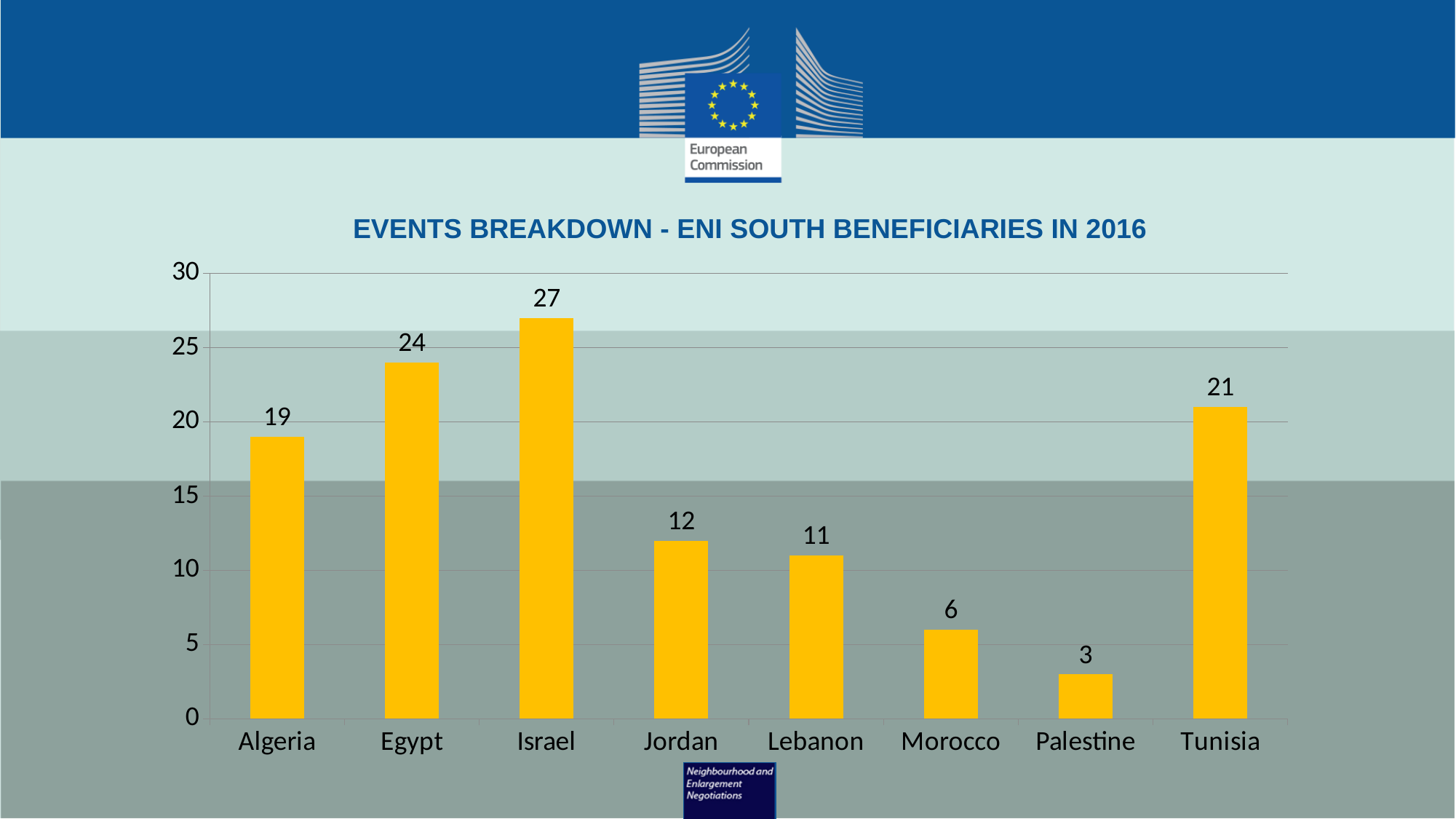
Which country has the lowest value? Palestine What is the value for Israel? 27 What is the difference between the values for Egypt and Jordan? 12 Which country has the highest value? Israel What is the value for Morocco? 6 How many countries are shown on the chart? 8 What kind of chart is shown on the slide? bar chart What is the difference between the values for Algeria and Lebanon? 8 What is the value for Tunisia? 21 Which is larger, the value for Algeria or the value for Tunisia? Tunisia What is the title of the chart? EVENTS BREAKDOWN - ENI SOUTH BENEFICIARIES IN 2016 Is the value for Egypt greater or less than 20? greater